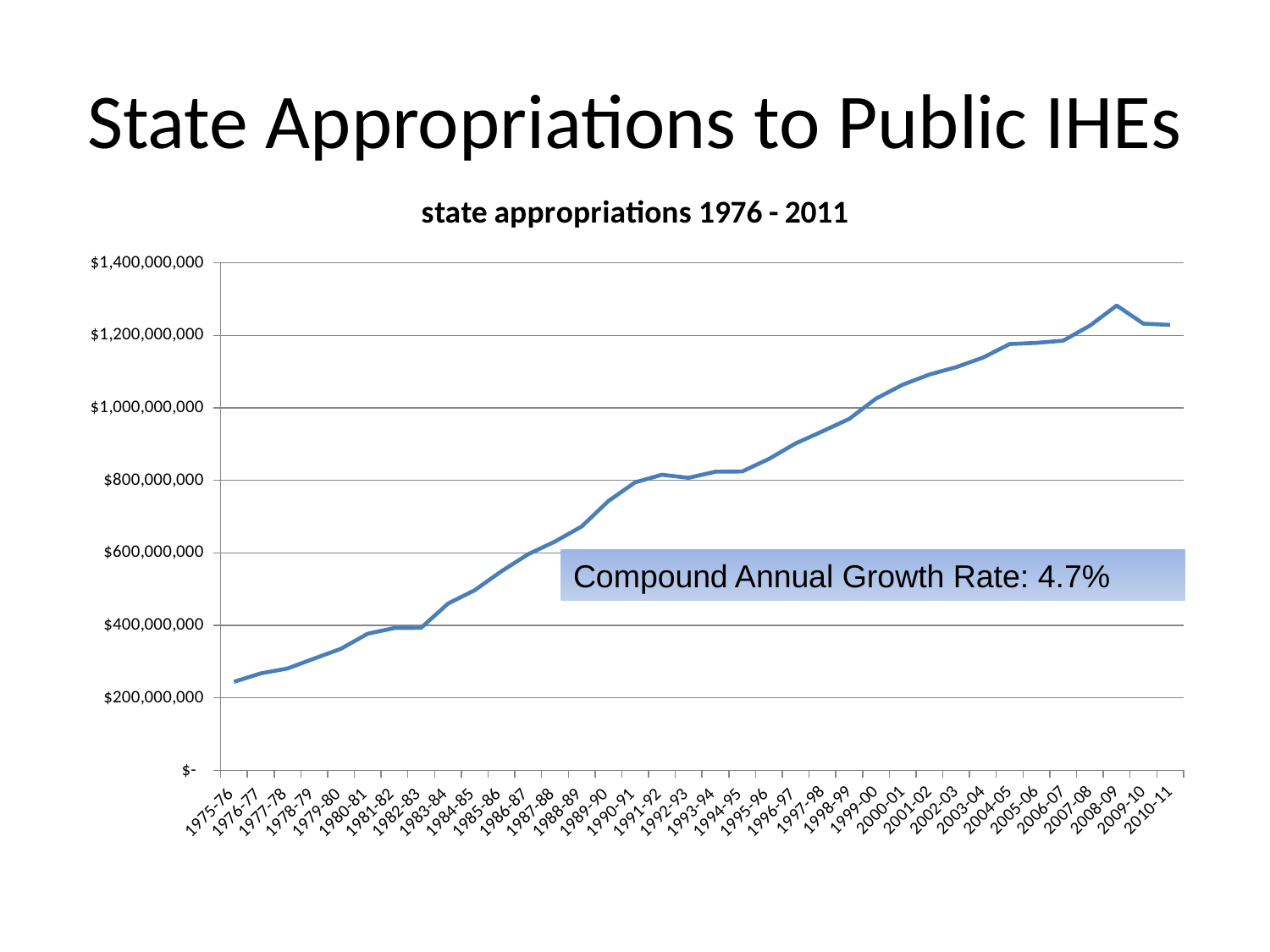
Is the value for 2008-09 greater or less than $1,200,000,000? greater Which fiscal year has the lowest state appropriation? 1975-76 Which fiscal year has the highest state appropriation? 2008-09 What is the title of the chart? state appropriations 1976 - 2011 What compound annual growth rate is stated in the text box on the chart? 4.7% Do state appropriations generally rise or fall from 1975-76 to 2010-11? rise Is the value for 1975-76 greater or less than $400,000,000? less Which is larger, the value for 2008-09 or the value for 2010-11? 2008-09 Is the value for 1995-96 greater or less than $800,000,000? greater How many fiscal years are plotted along the x axis? 36 What kind of chart is shown on the slide? line chart